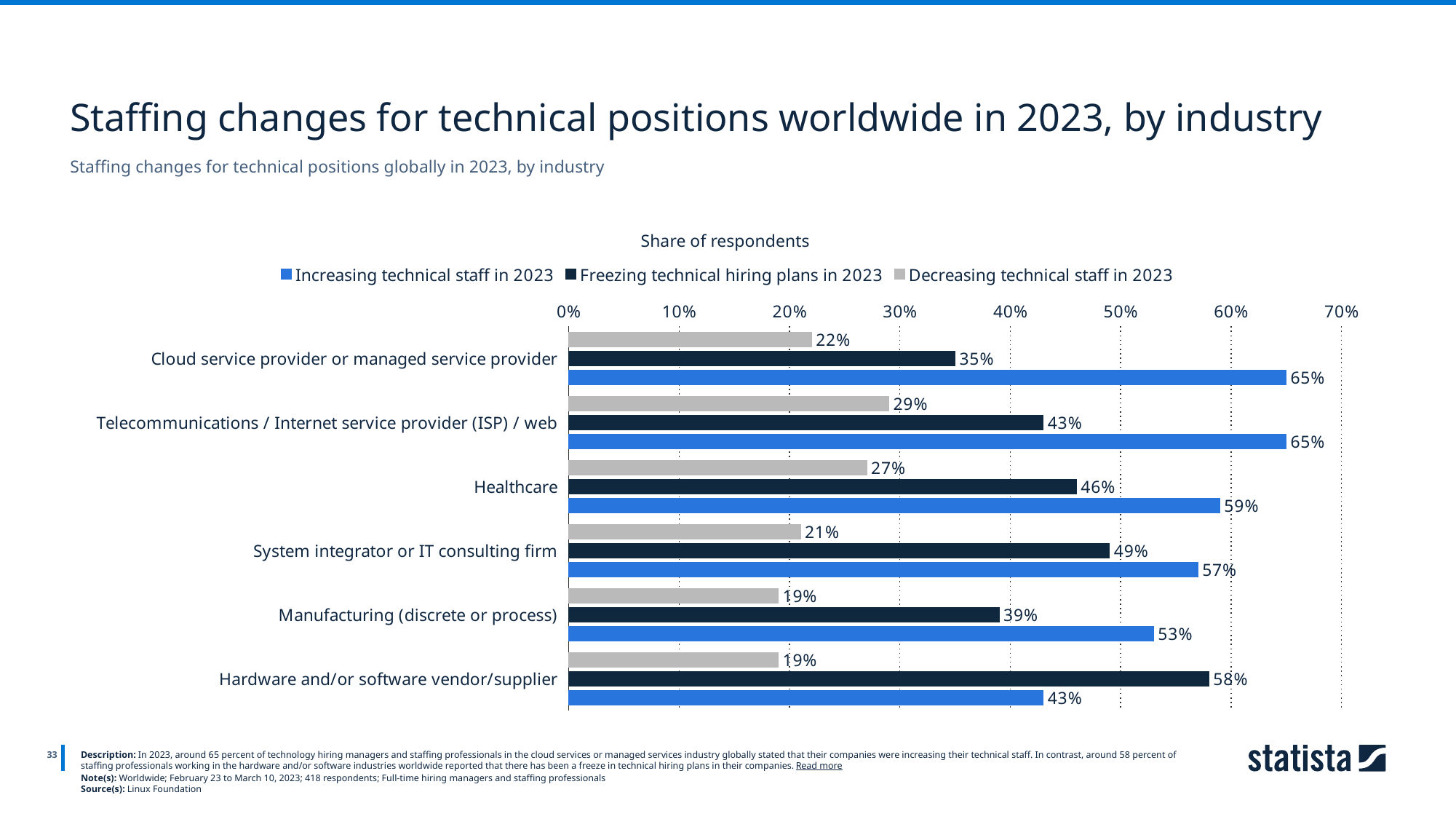
How many series does the legend list? 3 What share of respondents in Healthcare reported increasing technical staff in 2023? 59% Which industry has the highest share of respondents freezing technical hiring plans in 2023? Hardware and/or software vendor/supplier Which industry has the lowest share of respondents increasing technical staff in 2023? Hardware and/or software vendor/supplier Is the share of respondents decreasing technical staff in the Telecommunications / Internet service provider (ISP) / web industry greater or less than 20%? greater Which is larger for System integrator or IT consulting firm: the share increasing technical staff or the share freezing technical hiring plans? Increasing technical staff in 2023 What share of respondents in Manufacturing (discrete or process) reported decreasing technical staff in 2023? 19% Which colour represents 'Decreasing technical staff in 2023' in the chart? Grey What share of respondents in the Hardware and/or software vendor/supplier industry reported freezing technical hiring plans in 2023? 58% What kind of chart is shown on the slide? Bar chart What is the difference between the share of respondents increasing technical staff and the share freezing hiring plans for Cloud service provider or managed service provider? 30% How many industries are shown in the chart? 6